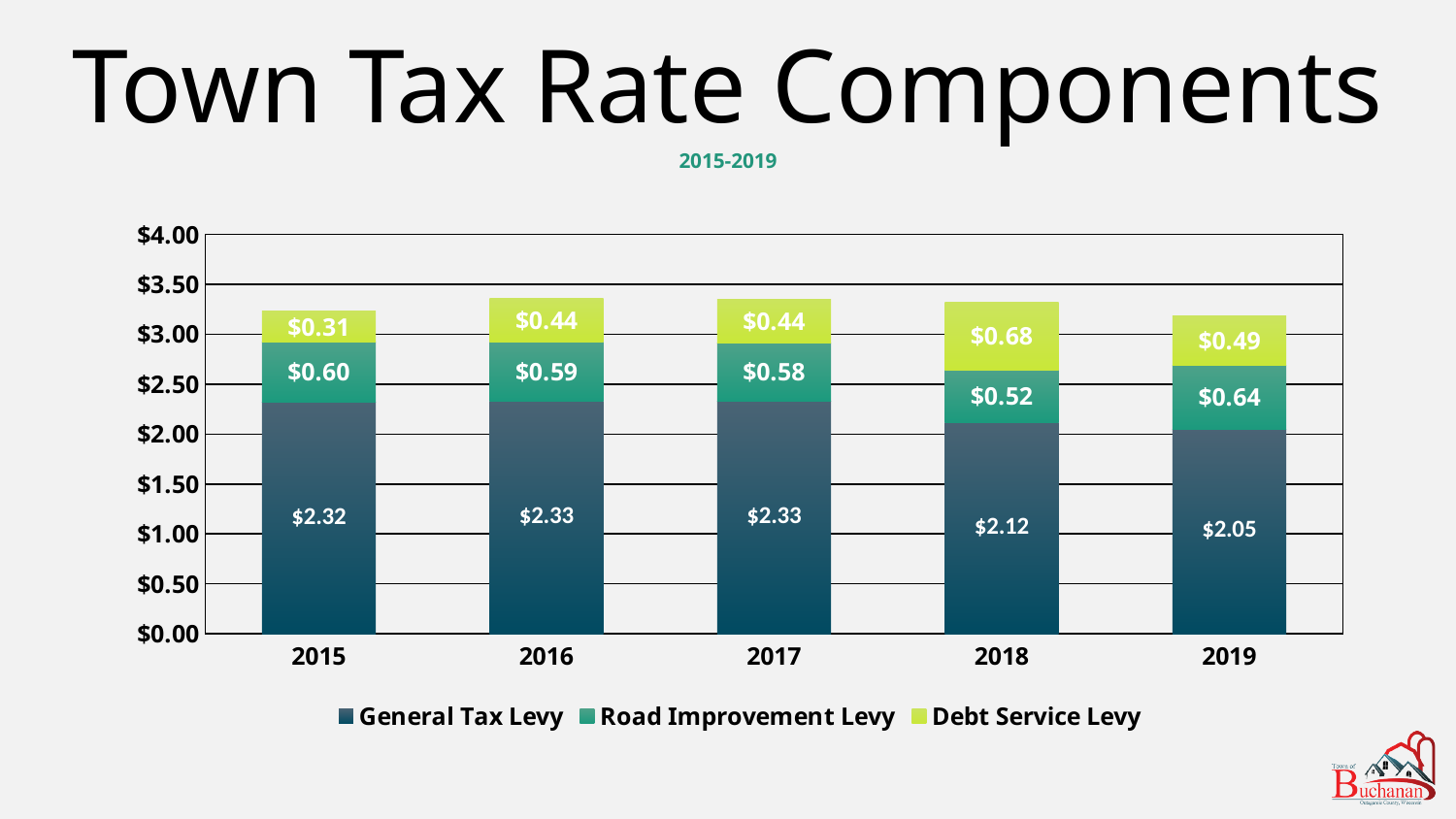
What is the General Tax Levy value for 2015? $2.32 What is the difference between the General Tax Levy in 2015 and in 2019? $0.27 In which year is the General Tax Levy lowest? 2019 What is the Debt Service Levy value for 2018? $0.68 In which year is the Debt Service Levy lowest? 2015 Which is larger, the Road Improvement Levy in 2015 or in 2018? 2015 In which year is the Debt Service Levy highest? 2018 How many series does the legend list? 3 What kind of chart is shown on the slide? Stacked bar chart What is the total of the stacked bar for 2015? $3.23 How many years are shown on the x axis? 5 What is the Road Improvement Levy value for 2019? $0.64